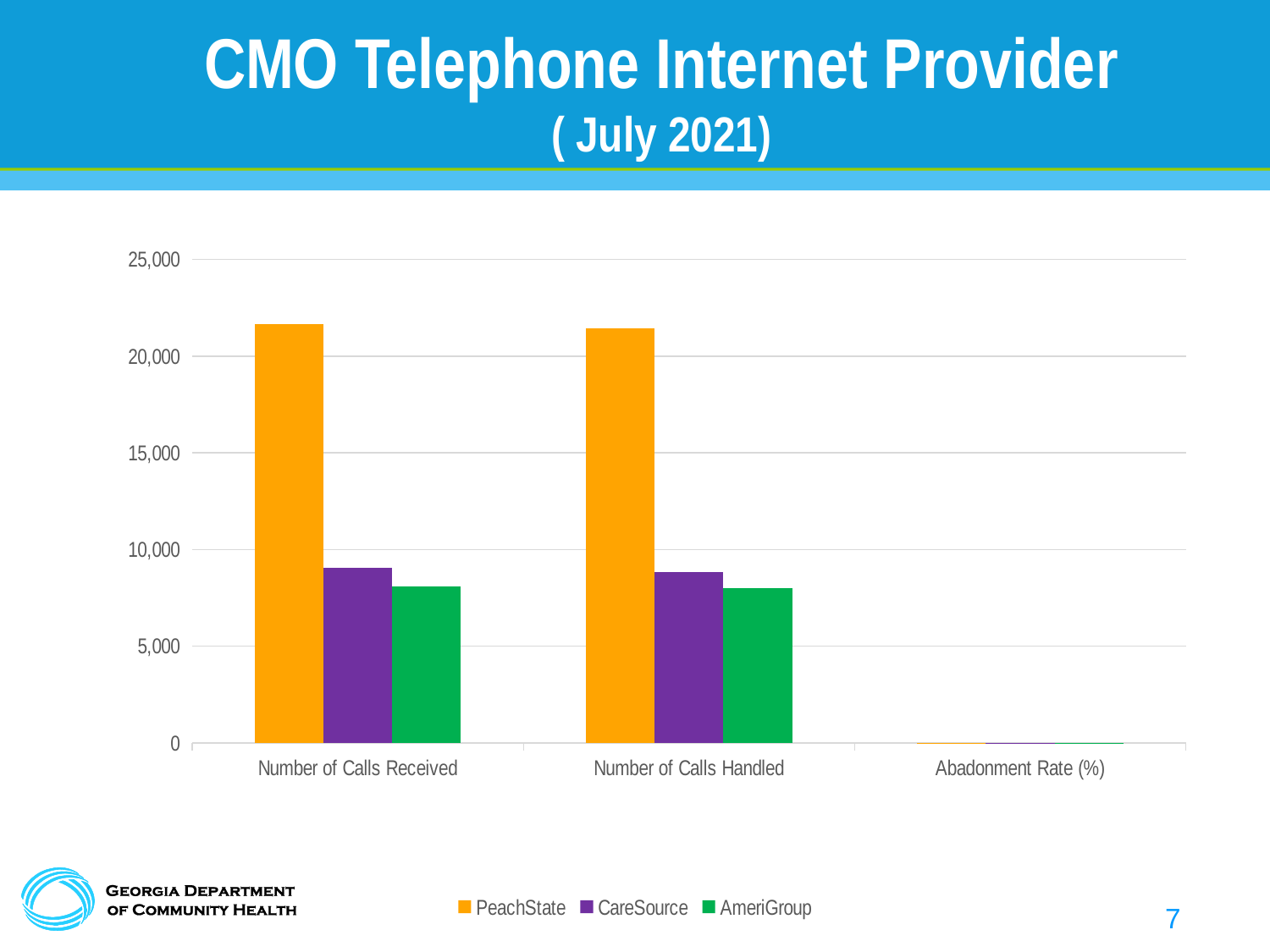
Is the value for CareSource in Number of Calls Received greater or less than 10,000? less How many categories are shown on the x axis? 3 Which series has the highest value for Number of Calls Received? PeachState Is the value for AmeriGroup in Number of Calls Handled greater or less than 5,000? greater Is the value for PeachState in Number of Calls Received greater or less than 20,000? greater Which is larger: PeachState's Number of Calls Handled or CareSource's Number of Calls Handled? PeachState What kind of chart is shown on the slide? bar chart What month and year does the chart title refer to? July 2021 Which series is shown in orange in the legend? PeachState How many series does the legend list? 3 Which series has the lowest value for Number of Calls Handled? AmeriGroup Which is larger: CareSource's Number of Calls Received or AmeriGroup's Number of Calls Received? CareSource